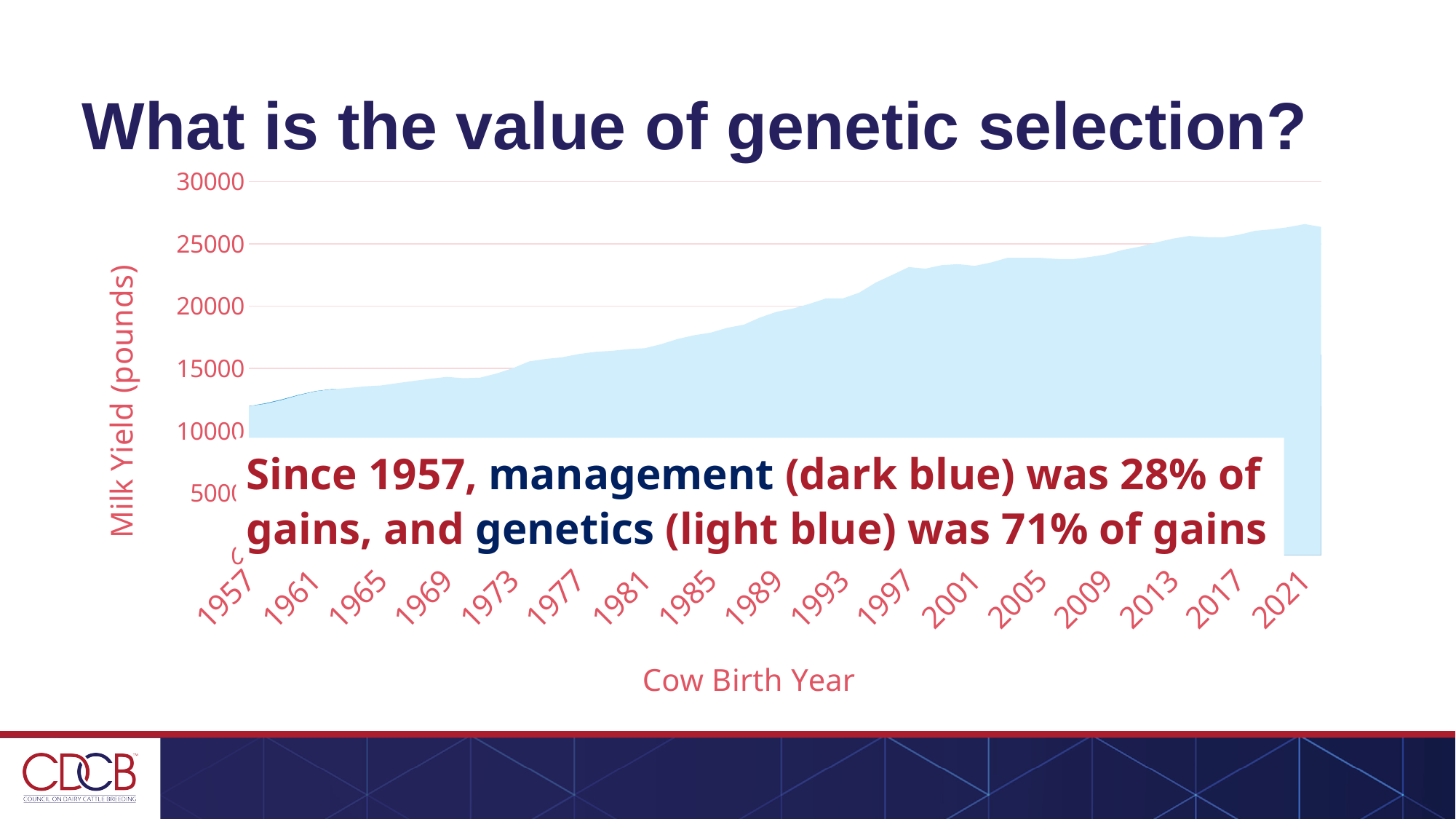
Is the milk yield for cows born in 1981 greater or less than 15000? greater Is the milk yield for cows born in 1957 greater or less than 15000? less What is the title of the vertical axis? Milk Yield (pounds) Which cow birth year has the lowest milk yield? 1957 What kind of chart is shown on the slide? area chart Is the milk yield for cows born in 1989 greater or less than 20000? less Which cow birth year has the highest milk yield? 2021 Which has the larger milk yield: cows born in 2021 or cows born in 1957? 2021 Do milk yield values rise or fall as cow birth year increases from 1957 to 2021? rise What is the title of the horizontal axis? Cow Birth Year